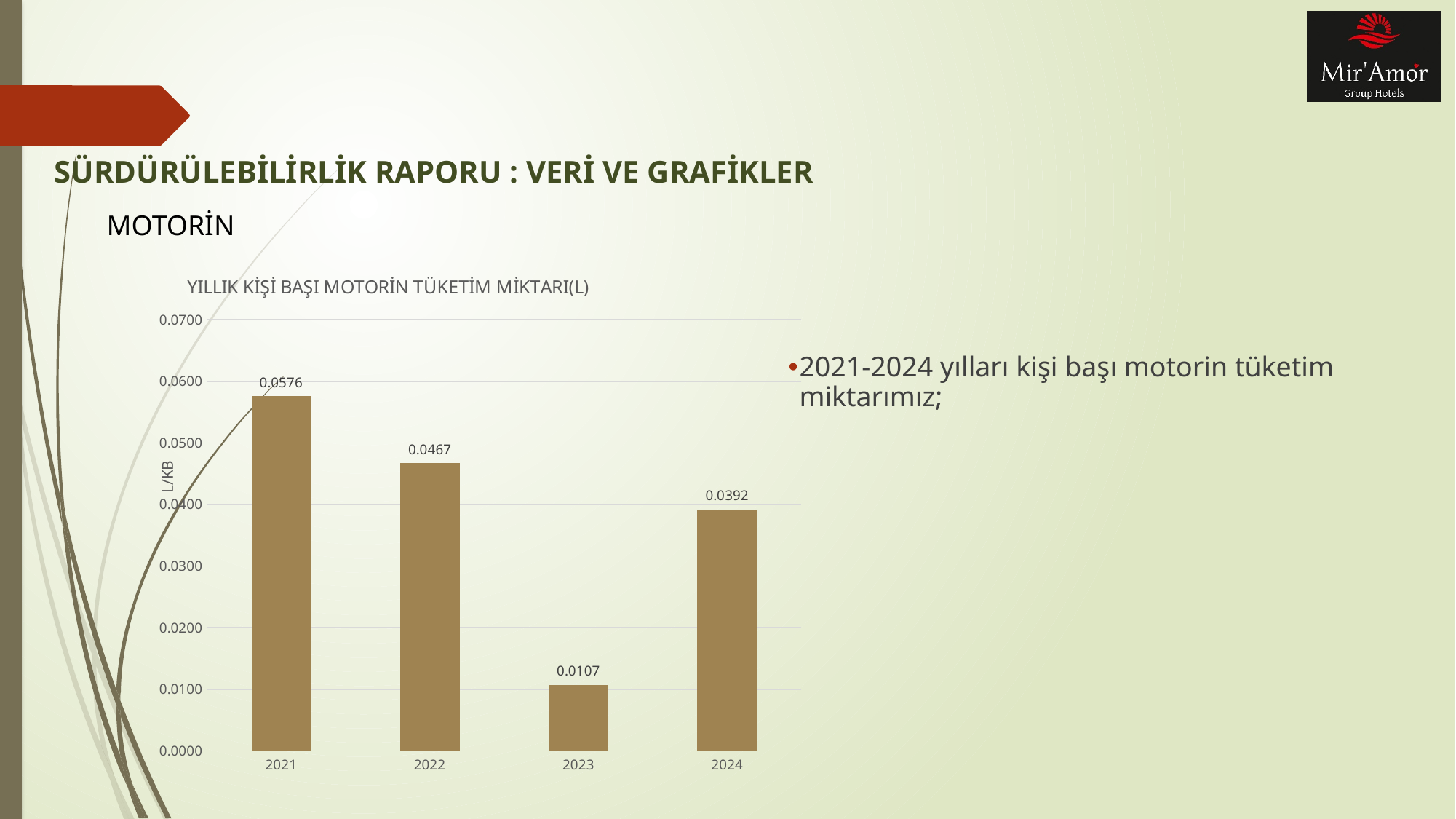
What is the value for 2024? 0.0392 What is the value for 2021? 0.0576 Which is larger, the value for 2022 or the value for 2024? 2022 What is the difference between the values for 2021 and 2022? 0.0109 What is the difference between the values for 2024 and 2023? 0.0285 How many years are shown on the x axis? 4 Which year has the lowest value? 2023 Which year has the highest value? 2021 What is the value for 2023? 0.0107 What kind of chart is shown? bar chart Is the value for 2022 greater or less than 0.0400? greater What is the title of the chart? YILLIK KİŞİ BAŞI MOTORİN TÜKETİM MİKTARI(L)